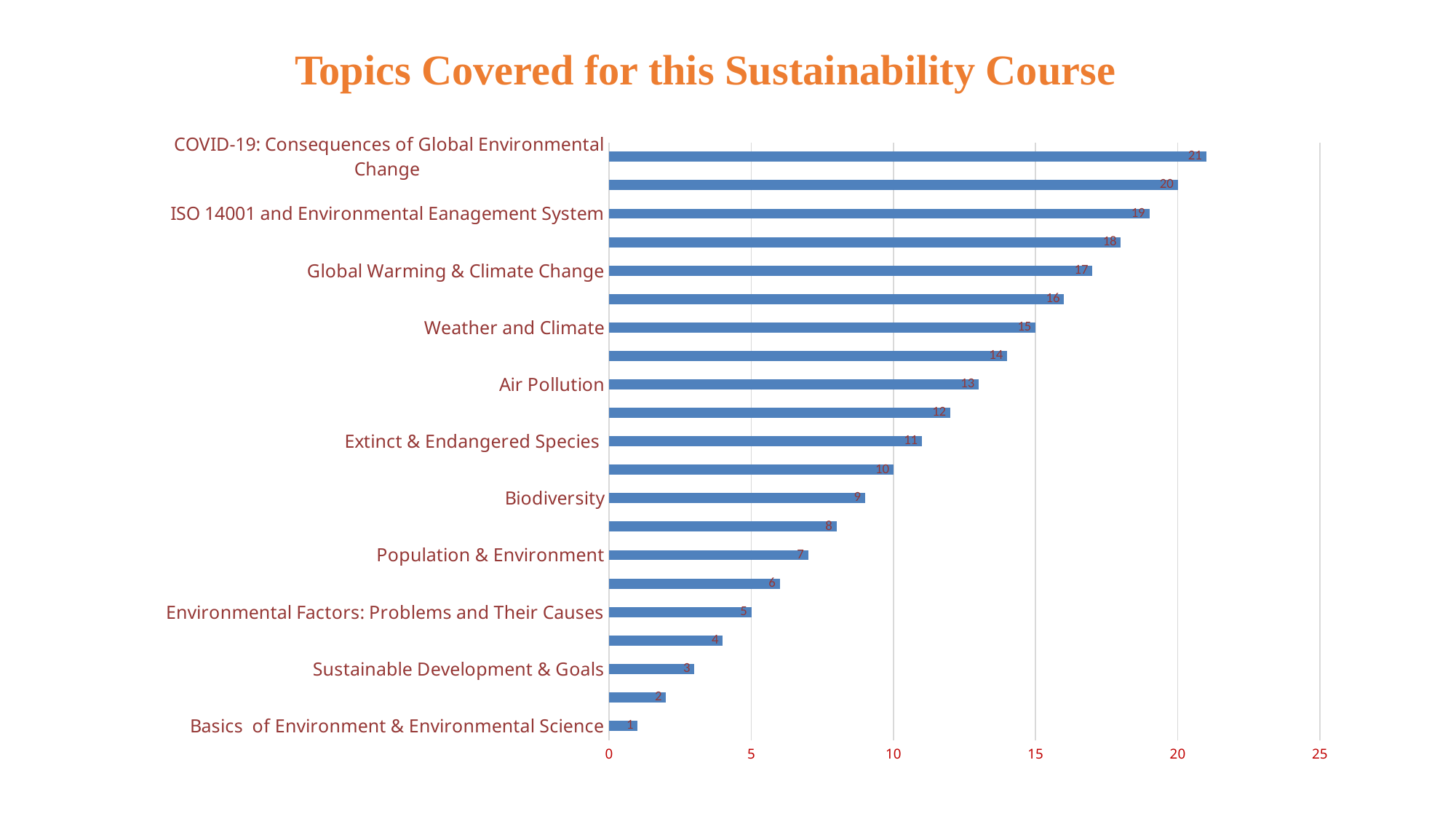
Which is larger, the value for Extinct & Endangered Species or the value for Population & Environment? Extinct & Endangered Species Which category has the highest value? COVID-19: Consequences of Global Environmental Change What is the value for COVID-19: Consequences of Global Environmental Change? 21 How many bars are plotted in the chart? 21 What type of chart is shown on the slide? bar chart What is the value for Global Warming & Climate Change? 17 What is the value for Basics of Environment & Environmental Science? 1 What is the value for Air Pollution? 13 What is the difference between the values for ISO 14001 and Environmental Eanagement System and Weather and Climate? 4 What is the title of the chart? Topics Covered for this Sustainability Course What is the value for Biodiversity? 9 Which category has the lowest value? Basics of Environment & Environmental Science